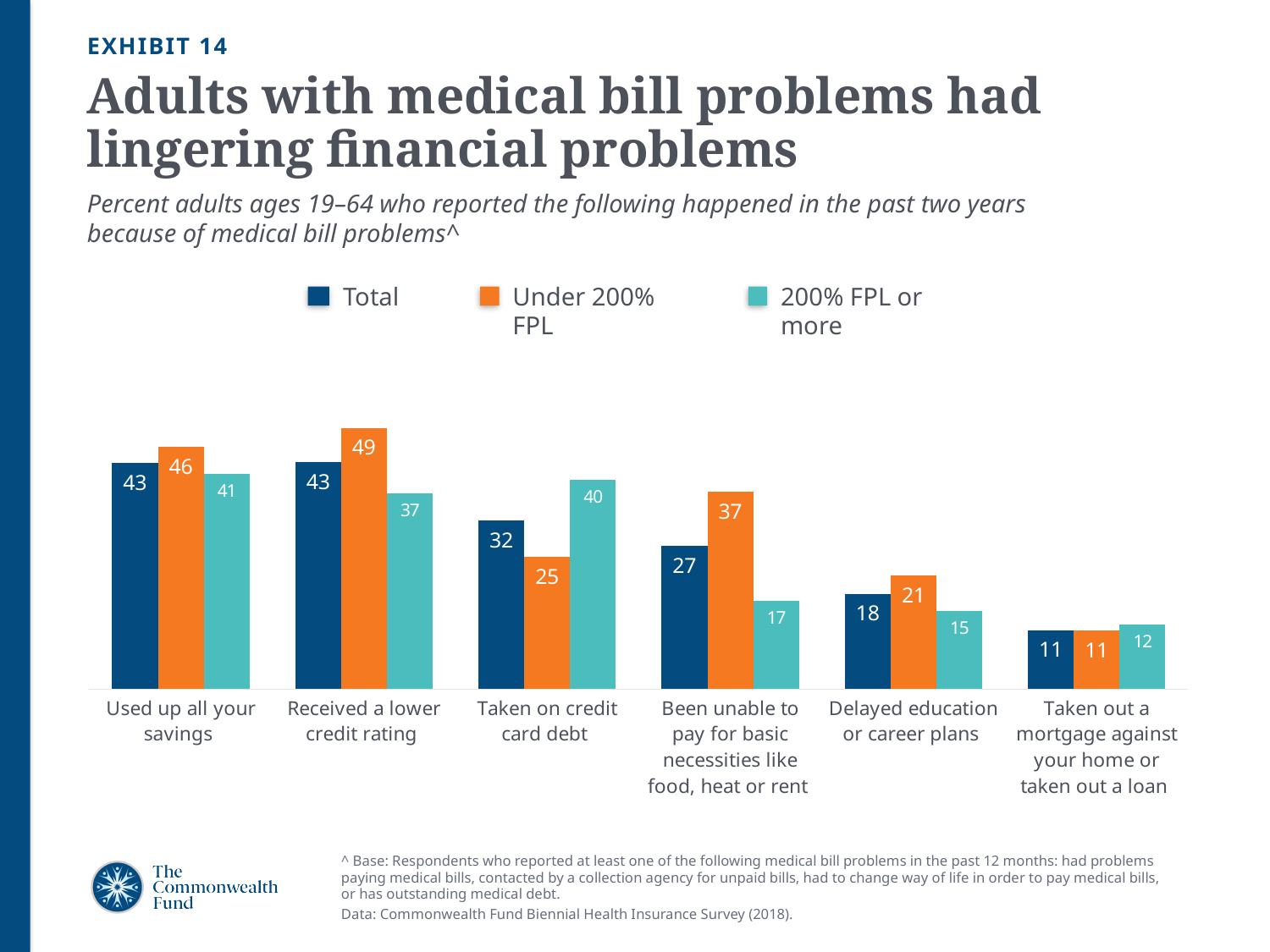
What is the difference between the Under 200% FPL and 200% FPL or more values for "Been unable to pay for basic necessities like food, heat or rent"? 20 For "Taken on credit card debt", which is larger: the Under 200% FPL value or the 200% FPL or more value? 200% FPL or more Which series is shown in orange in the legend? Under 200% FPL How many categories are shown on the x axis? 6 What is the Total value for "Taken on credit card debt"? 32 How many series does the legend list? 3 Which category has the lowest Total value? Taken out a mortgage against your home or taken out a loan What is the Under 200% FPL value for "Received a lower credit rating"? 49 What is the 200% FPL or more value for "Been unable to pay for basic necessities like food, heat or rent"? 17 Do the Total values rise or fall moving from left to right across the categories? Fall Which category has the highest Under 200% FPL value? Received a lower credit rating What kind of chart is shown on the slide? Bar chart